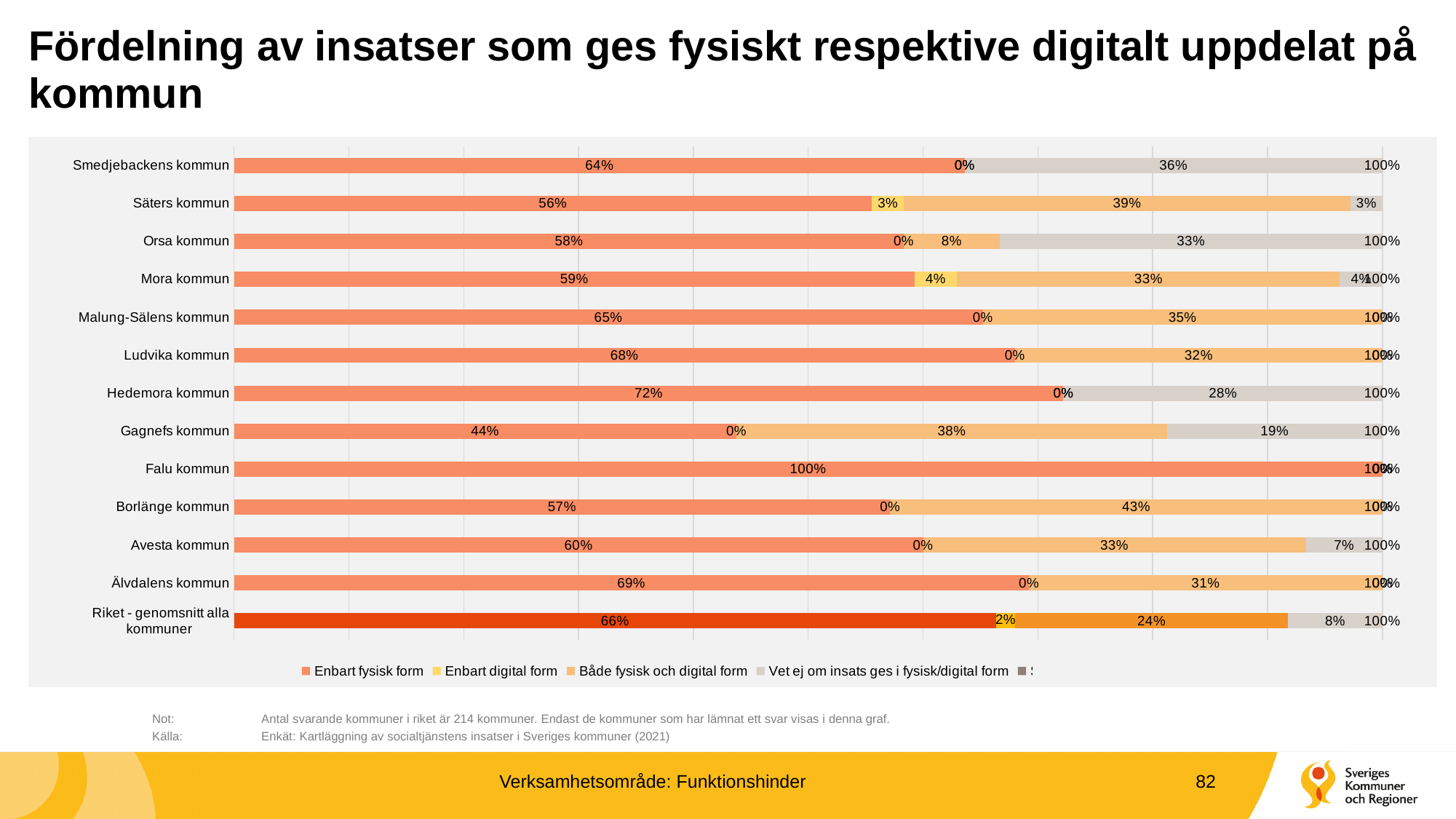
What is the difference in 'Enbart fysisk form' between Hedemora kommun (72%) and Gagnefs kommun (44%)? 28 percentage points Which category has the lowest value for 'Enbart fysisk form'? Gagnefs kommun What is the value of 'Både fysisk och digital form' for Borlänge kommun? 43% What is the value of 'Enbart fysisk form' for Hedemora kommun? 72% What is the value of 'Både fysisk och digital form' for 'Riket - genomsnitt alla kommuner'? 24% What is the title of the chart on the slide? Fördelning av insatser som ges fysiskt respektive digitalt uppdelat på kommun What is the value of 'Enbart digital form' for Säters kommun? 3% What is the value of 'Enbart fysisk form' for Falu kommun? 100% Which category has the highest value for 'Enbart fysisk form'? Falu kommun Which has a larger 'Enbart fysisk form' value, Hedemora kommun or Säters kommun? Hedemora kommun How many categories (rows) are plotted in the chart? 13 What kind of chart is shown on the slide? Stacked bar chart